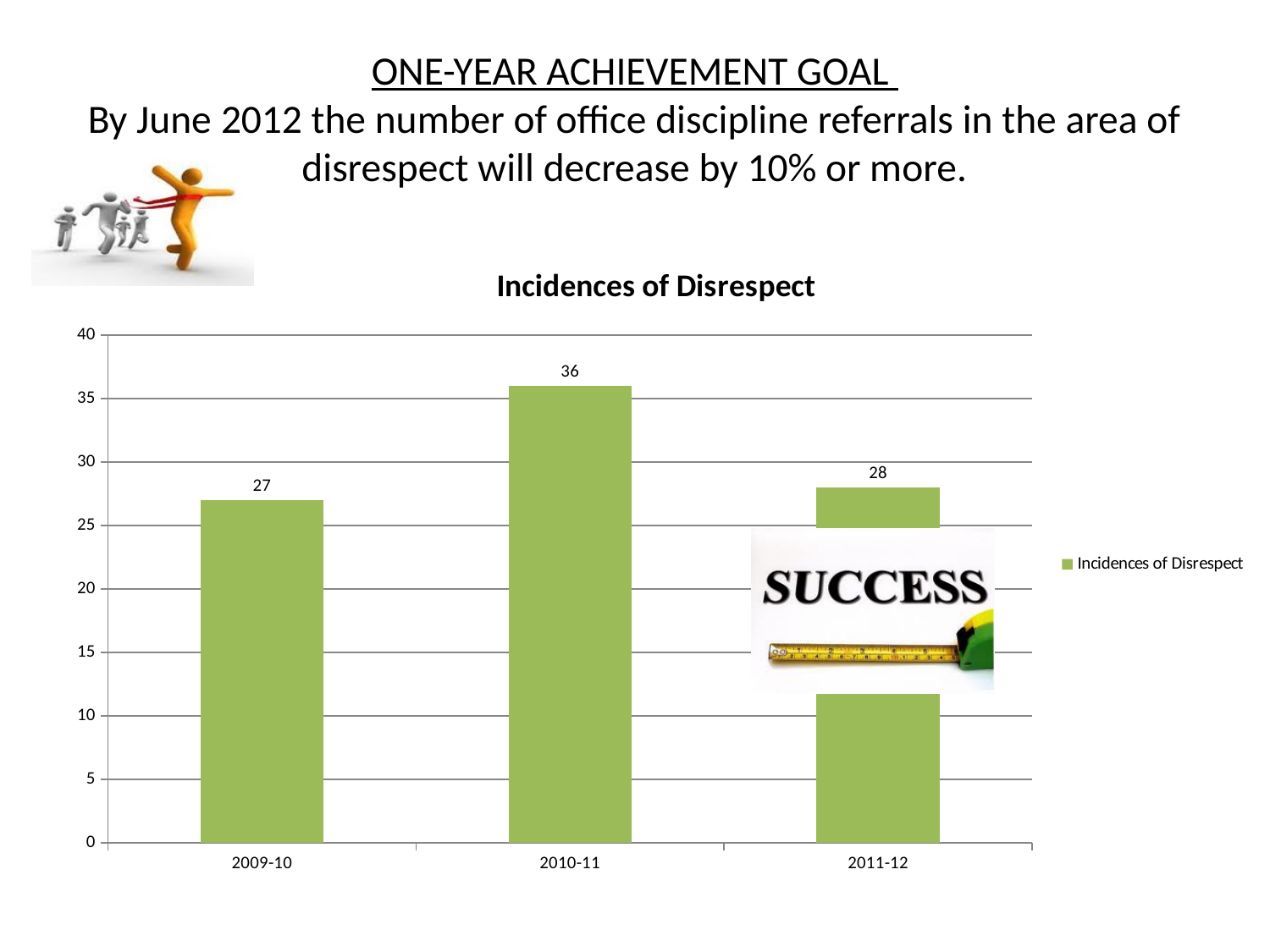
How many years are shown on the x axis? 3 Is the value for 2010-11 greater or less than 30? greater What is the value for 2010-11? 36 What kind of chart is shown? bar chart What is the value for 2009-10? 27 What is the value for 2011-12? 28 What is the title of the chart? Incidences of Disrespect Which is larger, the value for 2009-10 or the value for 2010-11? 2010-11 What is the difference between the values for 2010-11 and 2009-10? 9 Which year has the highest number of incidences of disrespect? 2010-11 What is the difference between the values for 2010-11 and 2011-12? 8 Which year has the lowest number of incidences of disrespect? 2009-10